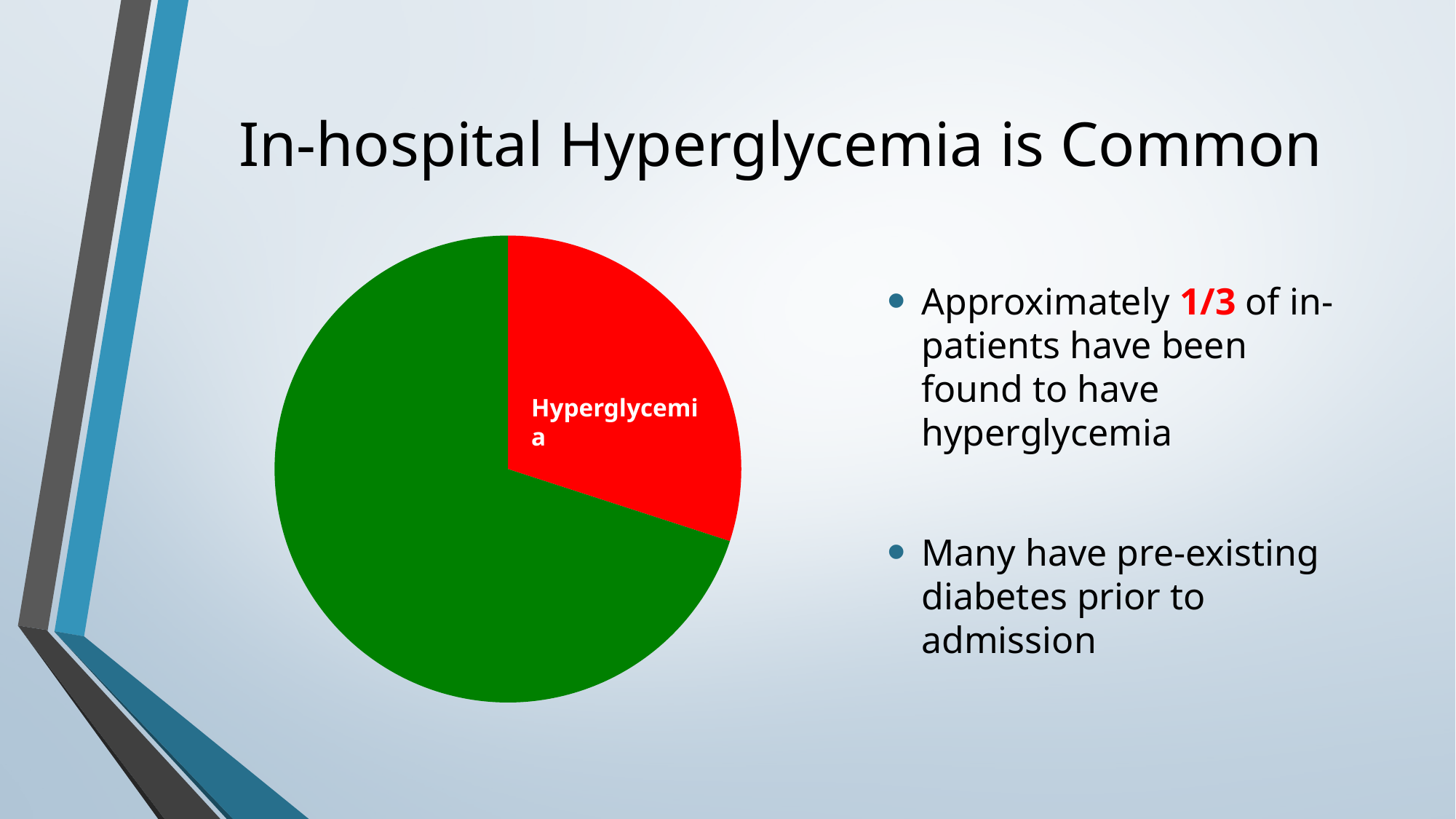
What is the label on the red slice of the pie chart? Hyperglycemia How many slices of the pie chart have a text label? 1 What colour is the Hyperglycemia slice of the pie chart? red Which slice of the pie chart is the smallest? Hyperglycemia Which slice of the pie chart is the largest? the green slice Is the Hyperglycemia slice larger or smaller than the green slice? smaller What kind of chart is shown on the slide? pie chart How many slices does the pie chart have? 2 Does the Hyperglycemia slice take up more or less than half of the pie? less